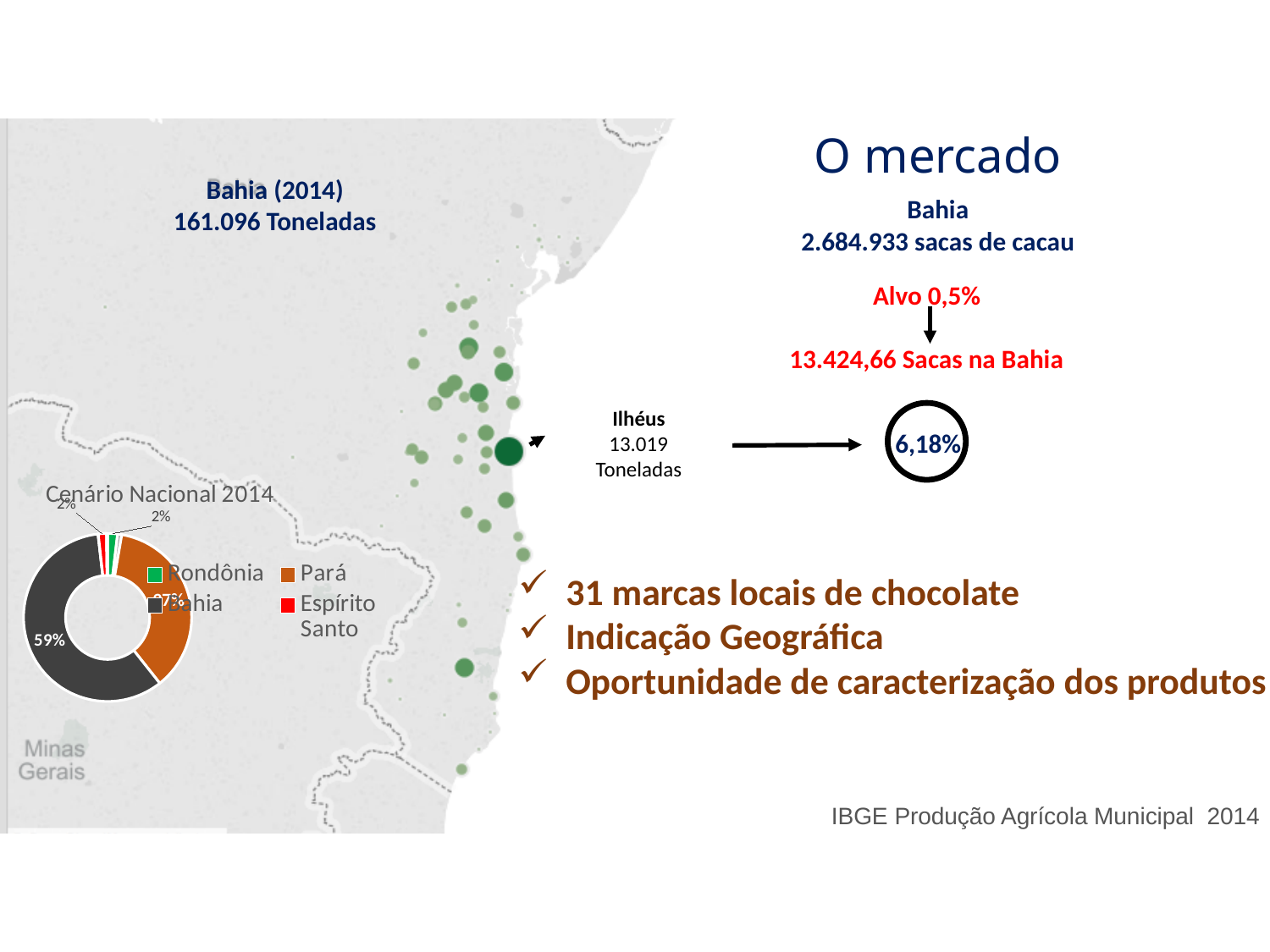
Which state has the largest slice in the 'Cenário Nacional 2014' chart? Bahia In the 'Cenário Nacional 2014' chart, what share does Rondônia have? 2% In the 'Cenário Nacional 2014' chart, which colour represents Pará? orange What kind of chart is the 'Cenário Nacional 2014' chart? doughnut (pie) chart In the 'Cenário Nacional 2014' chart, which slice is larger, Bahia or Pará? Bahia In the 'Cenário Nacional 2014' chart, what share does Espírito Santo have? 2% How many states are listed in the legend of the 'Cenário Nacional 2014' chart? 4 In the 'Cenário Nacional 2014' chart, what share does Bahia have? 59% In the 'Cenário Nacional 2014' chart, how many percentage points larger is Bahia's share than Rondônia's? 57% What is the title of the doughnut chart on the slide? Cenário Nacional 2014